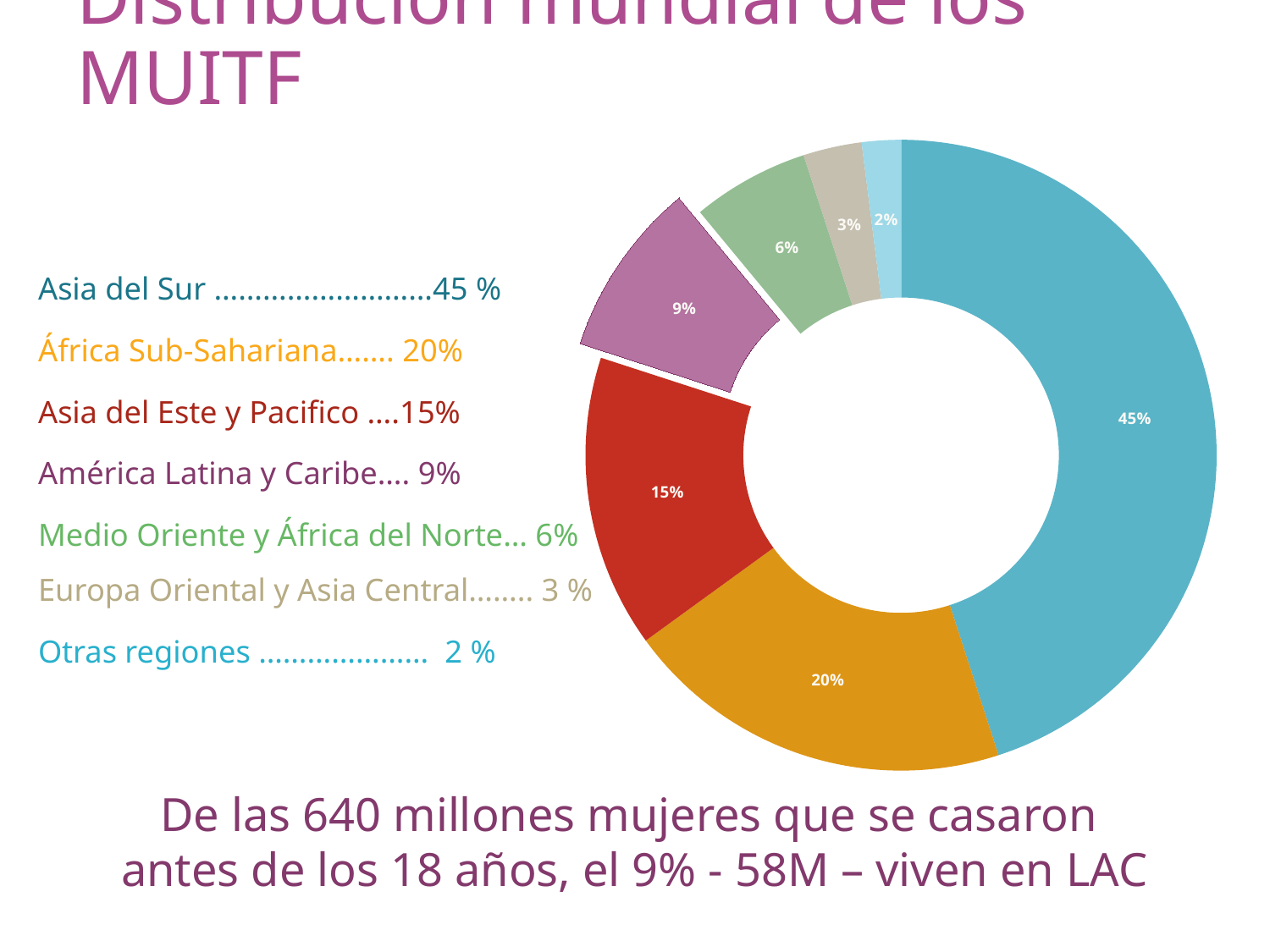
What is the value for Medio Oriente y África del Norte? 6% Which is larger, the share for Asia del Este y Pacifico or the share for América Latina y Caribe? Asia del Este y Pacifico What share of the pie does Asia del Sur hold? 45% What is the value for Asia del Este y Pacifico? 15% Which region has the smallest slice of the pie? Otras regiones How many slices does the pie chart have? 7 What is the value for África Sub-Sahariana? 20% What kind of chart is shown on the slide? Pie chart (donut) What is the difference between the shares of Asia del Sur and África Sub-Sahariana? 25% What is the value for América Latina y Caribe? 9% Which region has the largest slice of the pie? Asia del Sur Which slice is pulled out (exploded) from the rest of the pie? América Latina y Caribe (9%)